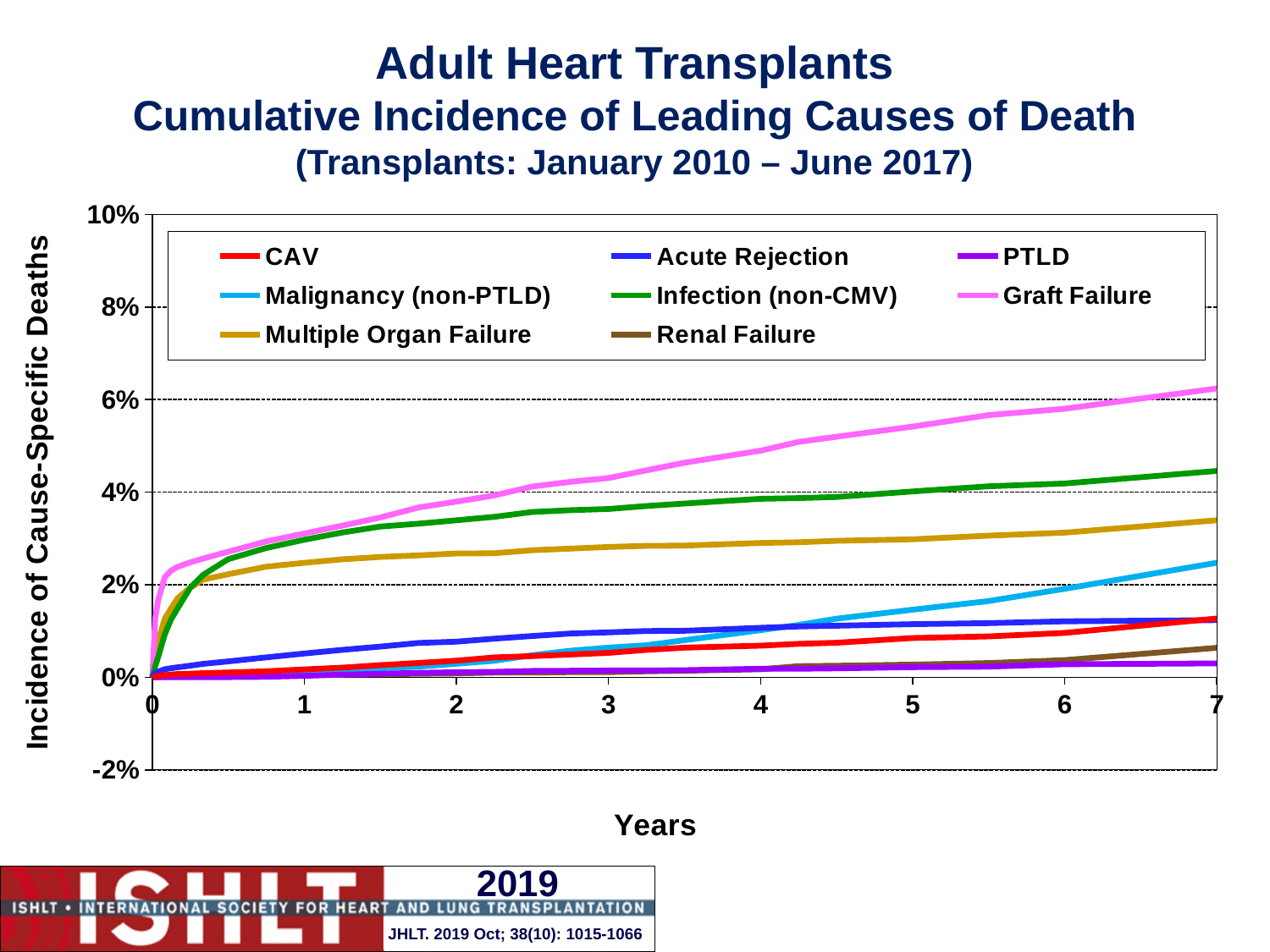
What is the label of the y axis? Incidence of Cause-Specific Deaths Which cause of death has the lowest cumulative incidence at year 7? PTLD Which cause of death has the highest cumulative incidence at year 7? Graft Failure What kind of chart is shown on the slide? Line chart Is the value for Infection (non-CMV) at year 7 greater or less than 4%? greater What transplant period does the chart subtitle state? January 2010 – June 2017 Is the value for Malignancy (non-PTLD) at year 7 greater or less than 2%? greater Is the value for Acute Rejection at year 7 greater or less than 2%? less At year 7, which is larger: Multiple Organ Failure or Malignancy (non-PTLD)? Multiple Organ Failure How many series does the legend list? 8 Does the Graft Failure line rise or fall as years increase? Rises